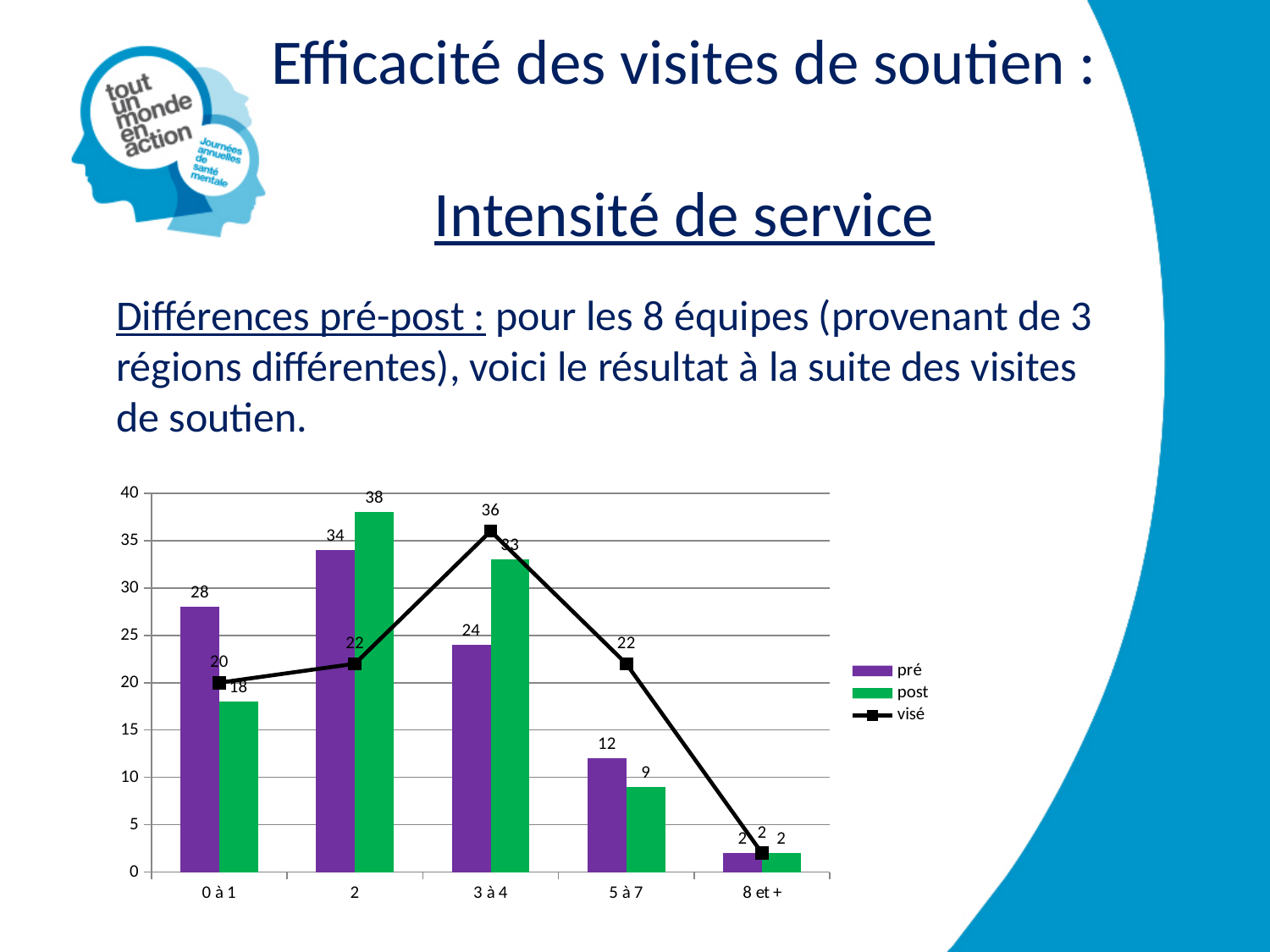
Which category has the highest 'post' value? 2 Which category has the lowest 'pré' value? 8 et + How many categories are shown on the x axis? 5 What is the value of the 'post' series for the category '2'? 38 What kind of chart is shown on the slide? Bar chart with a line series How many series does the legend list? 3 Which series is drawn as a black line with square markers? visé What is the value of the 'pré' series for the category '0 à 1'? 28 For the category '3 à 4', which is larger, the 'pré' value or the 'post' value? post What is the value of the 'visé' series for the category '3 à 4'? 36 What is the difference between the 'pré' and 'post' values for the category '0 à 1'? 10 What is the value of the 'post' series for the category '5 à 7'? 9